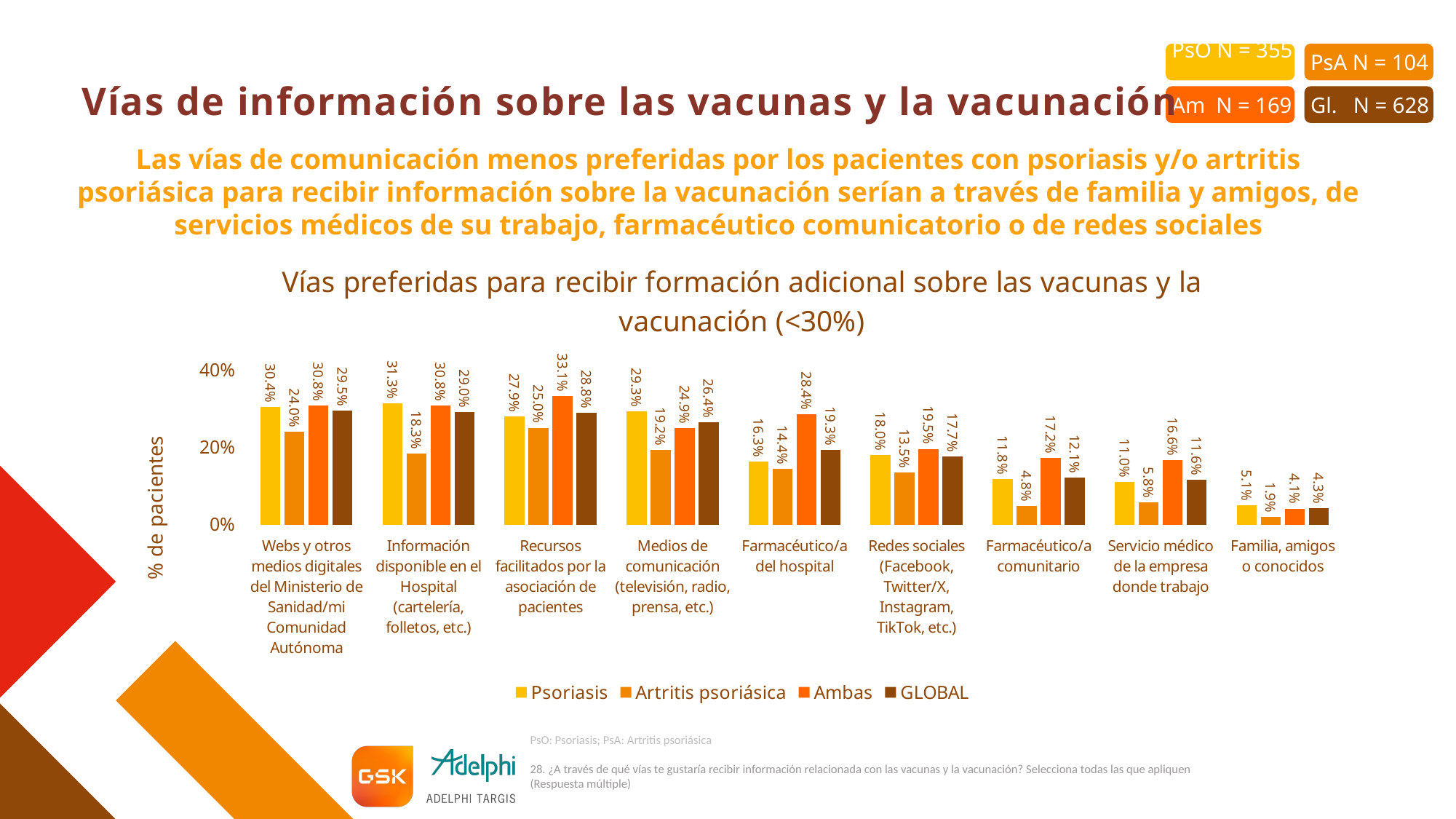
Which category has the lowest GLOBAL value? Familia, amigos o conocidos Which category has the highest Ambas value? Recursos facilitados por la asociación de pacientes What is the Ambas value for 'Farmacéutico/a del hospital'? 28.4% What is the Psoriasis value for 'Información disponible en el Hospital (cartelería, folletos, etc.)'? 31.3% How many series does the legend list? 4 What is the Artritis psoriásica value for 'Farmacéutico/a comunitario'? 4.8% How many categories are shown on the x axis? 9 What is the difference between the Ambas and Artritis psoriásica values for 'Farmacéutico/a del hospital'? 14.0% Is the Artritis psoriásica value for 'Servicio médico de la empresa donde trabajo' greater or less than 20%? less Which is larger for 'Medios de comunicación (televisión, radio, prensa, etc.)': the Psoriasis value or the Ambas value? Psoriasis What is the GLOBAL value for 'Familia, amigos o conocidos'? 4.3% What kind of chart is shown on the slide? bar chart